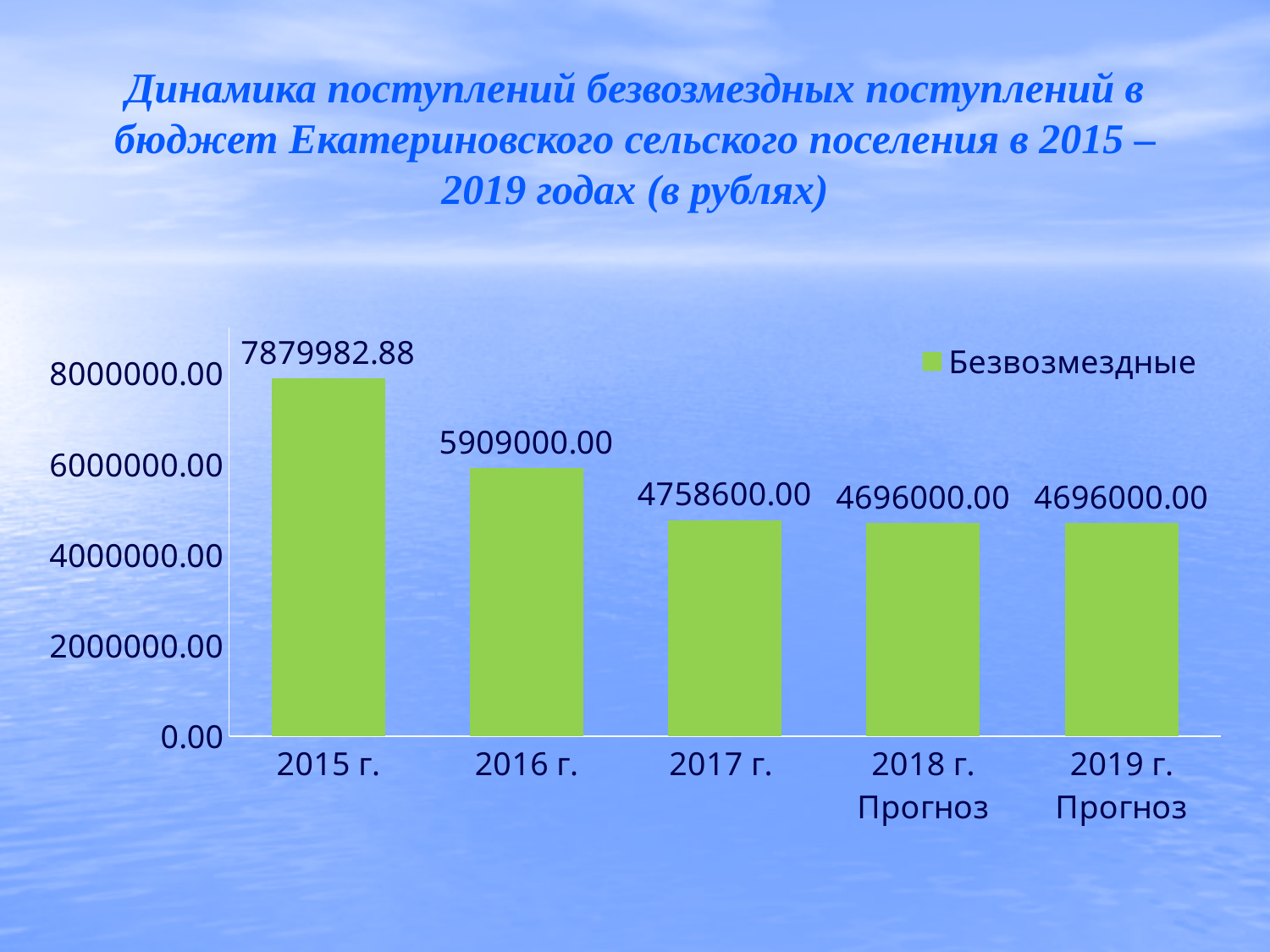
What is the difference between the values for 2016 г. and 2017 г.? 1150400.00 Is the value for 2017 г. greater or less than 4000000.00? greater What is the value for 2015 г.? 7879982.88 What is the difference between the values for 2015 г. and 2016 г.? 1970982.88 Which is larger, the value for 2016 г. or the value for 2017 г.? 2016 г. How many categories are shown on the x axis? 5 What kind of chart is shown on the slide? bar chart Which year has the highest value? 2015 г. Do the values rise or fall from 2015 г. to 2017 г.? fall What is the value for 2016 г.? 5909000.00 What is the value for 2018 г. Прогноз? 4696000.00 What is the value for 2017 г.? 4758600.00